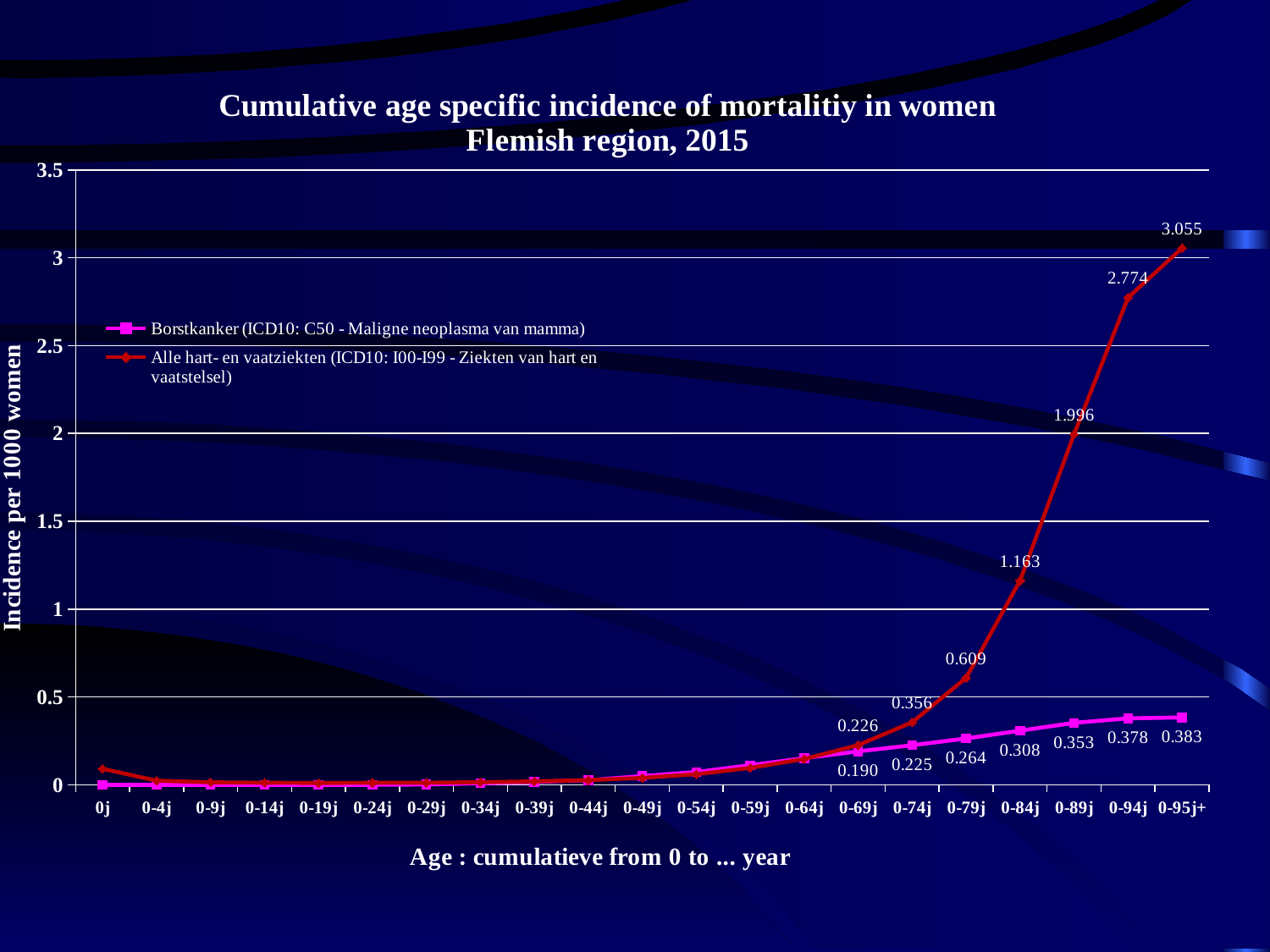
Which series has the larger value at 0-94j, Borstkanker or Alle hart- en vaatziekten? Alle hart- en vaatziekten Do the values of the Alle hart- en vaatziekten series rise or fall from 0-69j to 0-95j+? rise What is the value for Borstkanker at 0-95j+? 0.383 What is the value for Alle hart- en vaatziekten at 0-95j+? 3.055 How many series does the legend list? 2 What type of chart is shown on the slide? line chart How many age categories are shown on the x axis? 21 Is the value for Alle hart- en vaatziekten at 0-89j greater or less than 1.5? greater What is the difference between the Alle hart- en vaatziekten and Borstkanker values at 0-89j? 1.643 What is the value for Alle hart- en vaatziekten at 0-79j? 0.609 What is the value for Borstkanker at 0-84j? 0.308 At which age category does the Alle hart- en vaatziekten series reach its highest value? 0-95j+